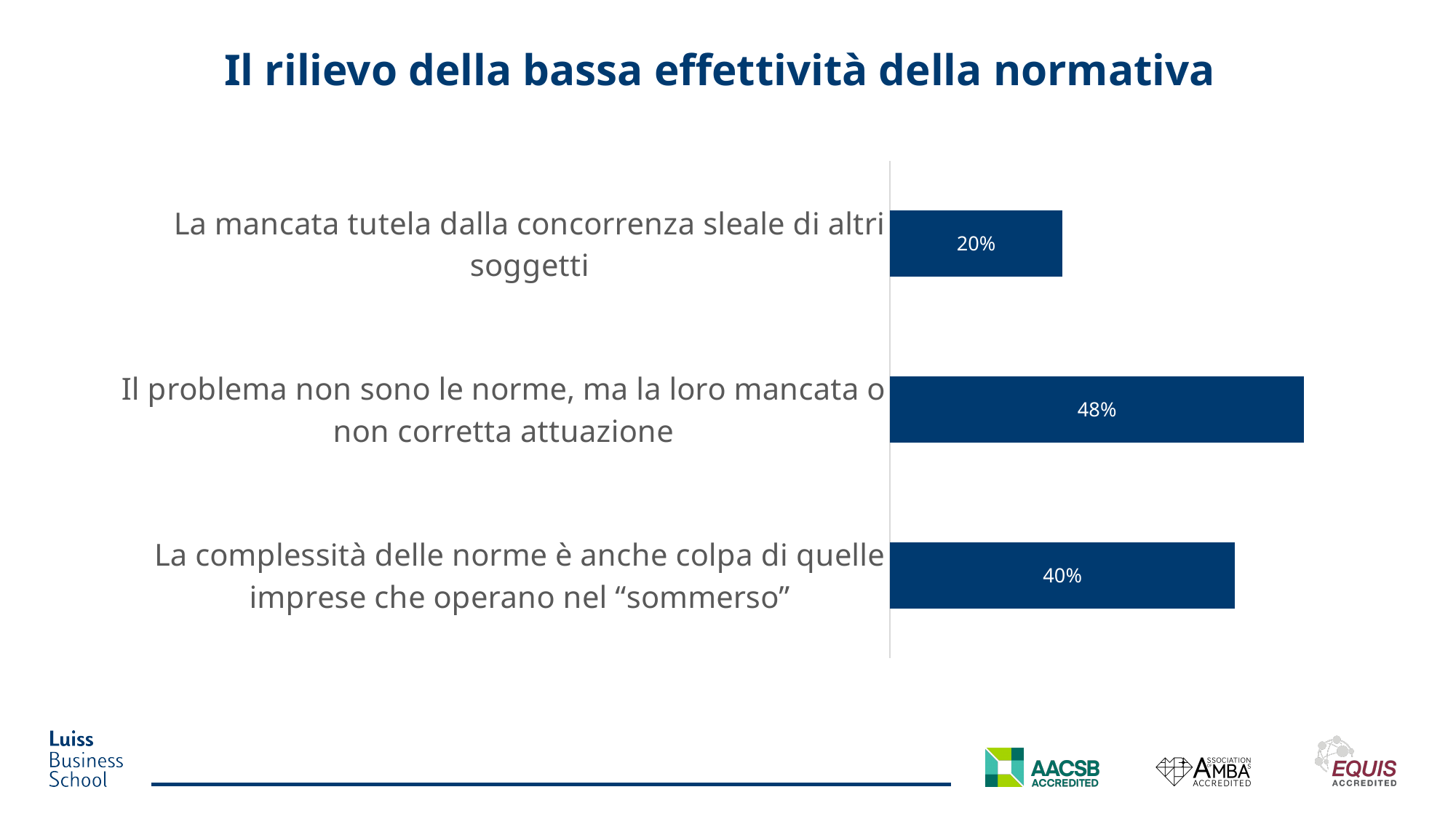
Which is larger: the value for "La mancata tutela dalla concorrenza sleale di altri soggetti" or the value for "La complessità delle norme è anche colpa di quelle imprese che operano nel “sommerso”"? La complessità delle norme è anche colpa di quelle imprese che operano nel “sommerso” What kind of chart is shown on the slide? Bar chart What is the difference between the value for "Il problema non sono le norme, ma la loro mancata o non corretta attuazione" and the value for "La complessità delle norme è anche colpa di quelle imprese che operano nel “sommerso”"? 8% Which category has the lowest value? La mancata tutela dalla concorrenza sleale di altri soggetti What is the value for "La mancata tutela dalla concorrenza sleale di altri soggetti"? 20% What is the value for "Il problema non sono le norme, ma la loro mancata o non corretta attuazione"? 48% What is the value for "La complessità delle norme è anche colpa di quelle imprese che operano nel “sommerso”"? 40% Which category has the highest value? Il problema non sono le norme, ma la loro mancata o non corretta attuazione What colour are the bars in the chart? Dark blue What is the difference between the value for "La complessità delle norme è anche colpa di quelle imprese che operano nel “sommerso”" and the value for "La mancata tutela dalla concorrenza sleale di altri soggetti"? 20% What is the title of the slide? Il rilievo della bassa effettività della normativa How many categories are shown in the chart? 3